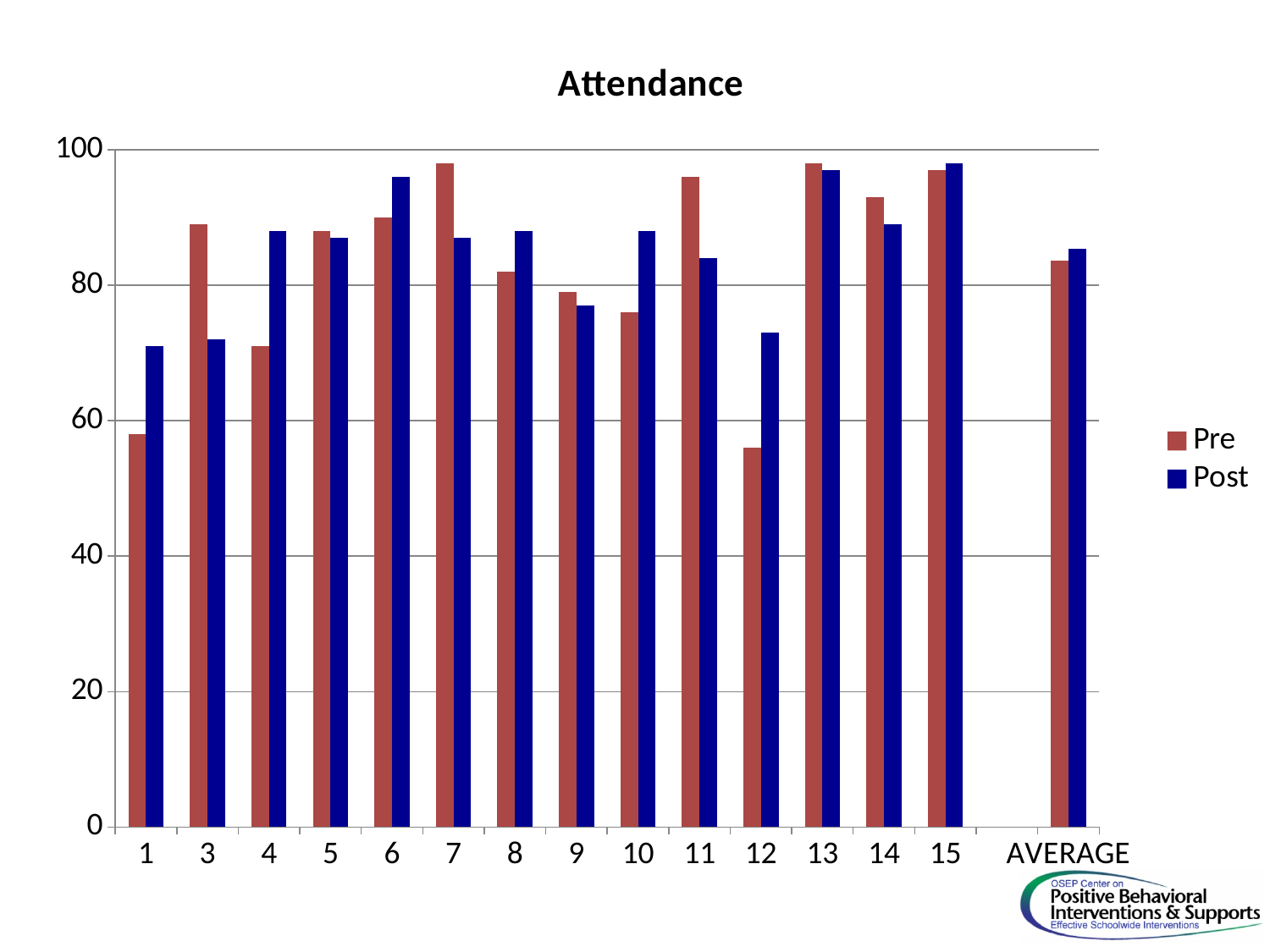
Is the Post value for category 12 greater or less than 80? less Is the Pre value for category 1 greater or less than 60? less What kind of chart is shown on the slide? bar chart For category 11, which is larger, the Pre value or the Post value? Pre Is the Pre value for category 12 greater or less than 60? less What is the title of the chart? Attendance For category 1, which is larger, the Pre value or the Post value? Post How many series does the legend list? 2 Which series is shown in blue? Post How many categories are shown along the x axis? 15 For category 3, which is larger, the Pre value or the Post value? Pre